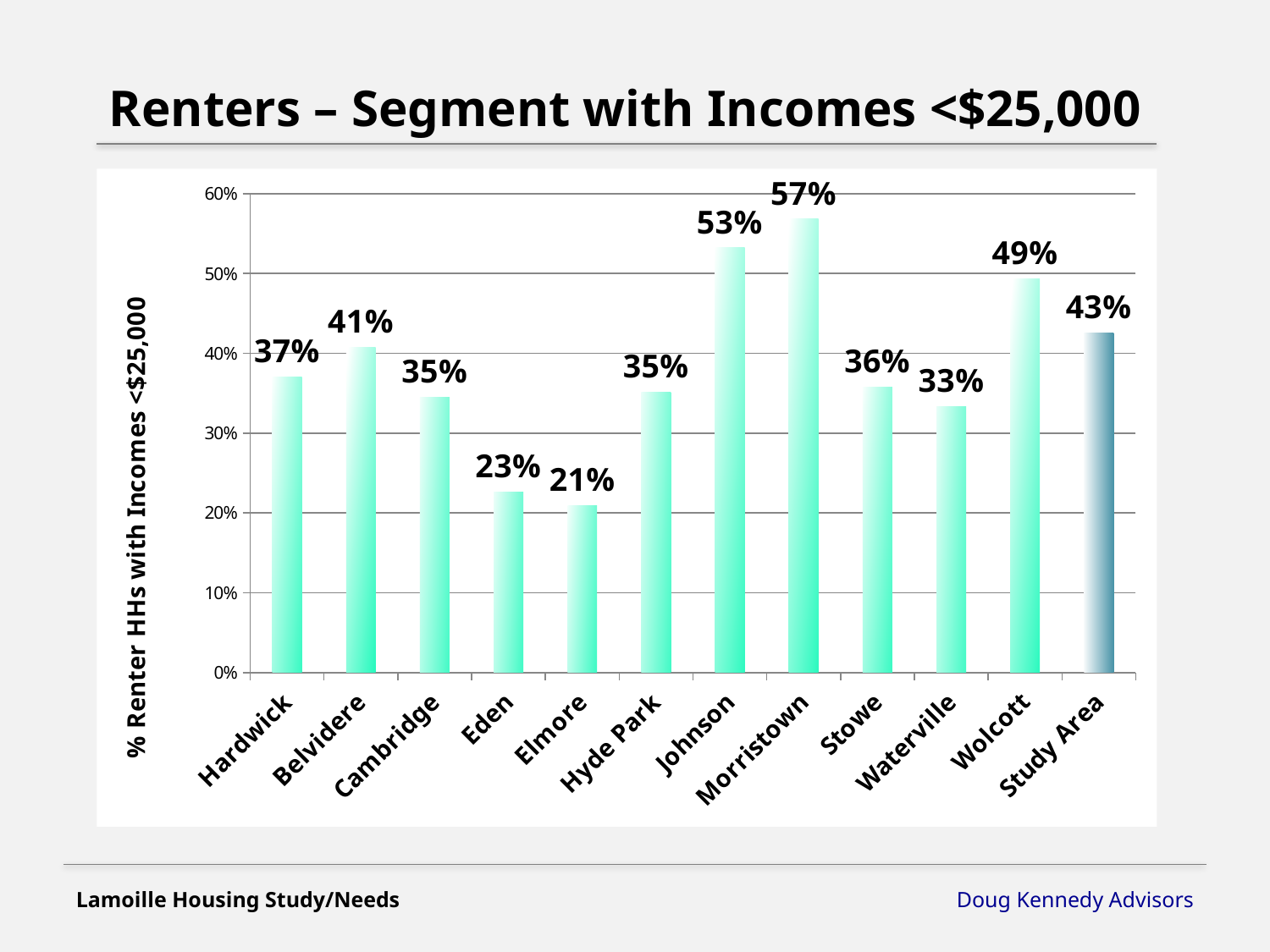
Which is larger, the value for Wolcott or the value for Belvidere? Wolcott What is the difference between the values for Johnson and Hardwick? 16% What is the value for Morristown? 57% What is the y-axis label of the chart? % Renter HHs with Incomes <$25,000 What is the title of the slide? Renters – Segment with Incomes <$25,000 What is the value for Elmore? 21% What kind of chart is shown on the slide? bar chart Which category has the highest value? Morristown Is the value for Eden greater or less than 30%? less What is the value for Study Area? 43% How many categories are shown on the x axis? 12 Which category has the lowest value? Elmore